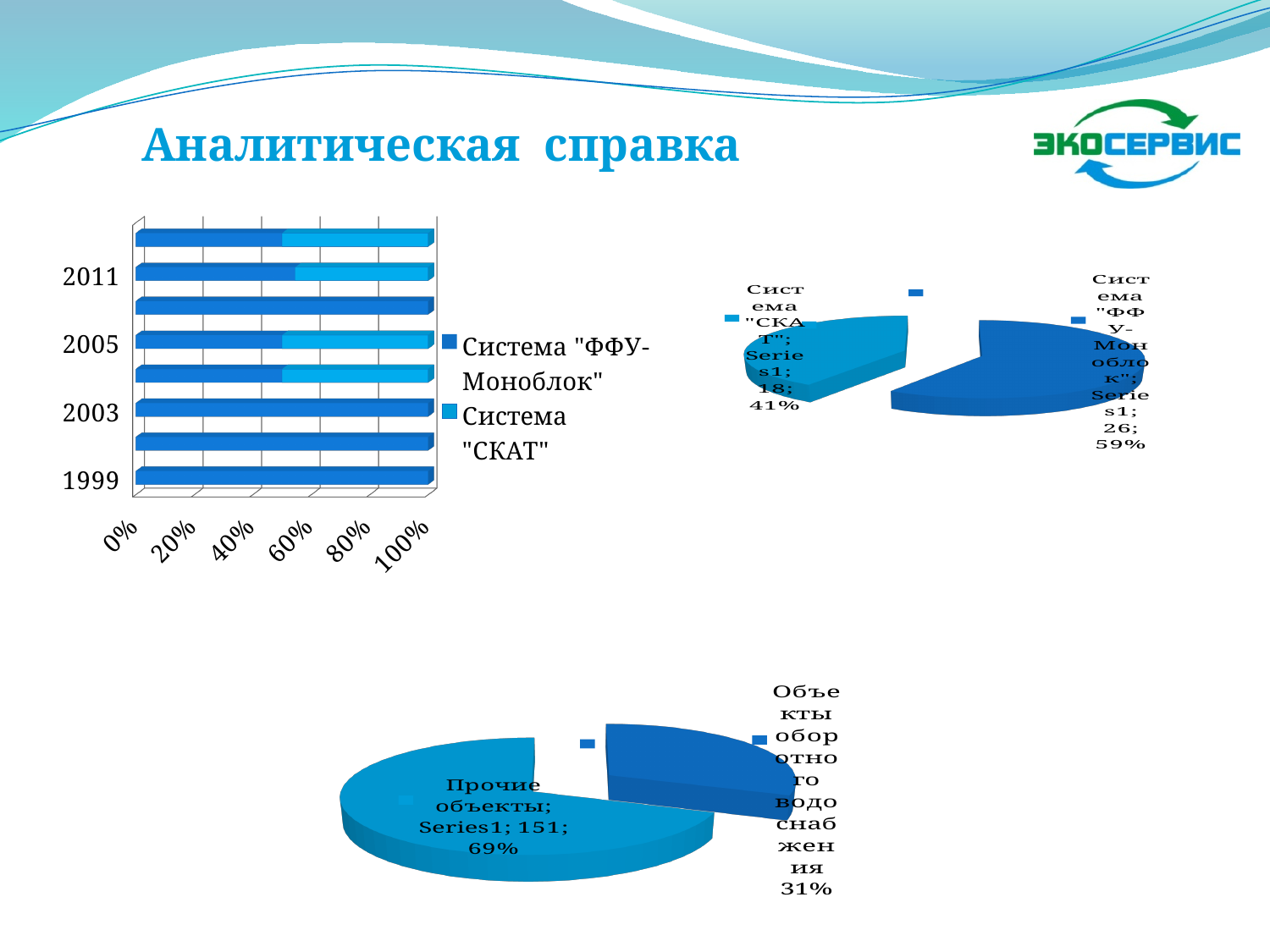
What kind of chart is the top-left chart on the slide? bar chart In the top-right pie chart, what is the difference between the values for Система "ФФУ-Моноблок" and Система "СКАТ"? 8 In the top-right pie chart, which slice is larger, Система "СКАТ" or Система "ФФУ-Моноблок"? Система "ФФУ-Моноблок" In the top-right pie chart, what is the value for Система "СКАТ"? 18 In the bottom pie chart, what is the share of Объекты оборотного водоснабжения? 31% In the top-right pie chart, what is the share of Система "СКАТ"? 41% In the top-right pie chart, what is the share of Система "ФФУ-Моноблок"? 59% In the top-left bar chart, which series is shown in the darker blue colour? Система "ФФУ-Моноблок" In the top-left bar chart, what is the highest value shown on the horizontal axis? 100% In the top-right pie chart, what is the value for Система "ФФУ-Моноблок"? 26 In the bottom pie chart, what is the value for Прочие объекты? 151 How many series does the legend of the top-left bar chart list? 2